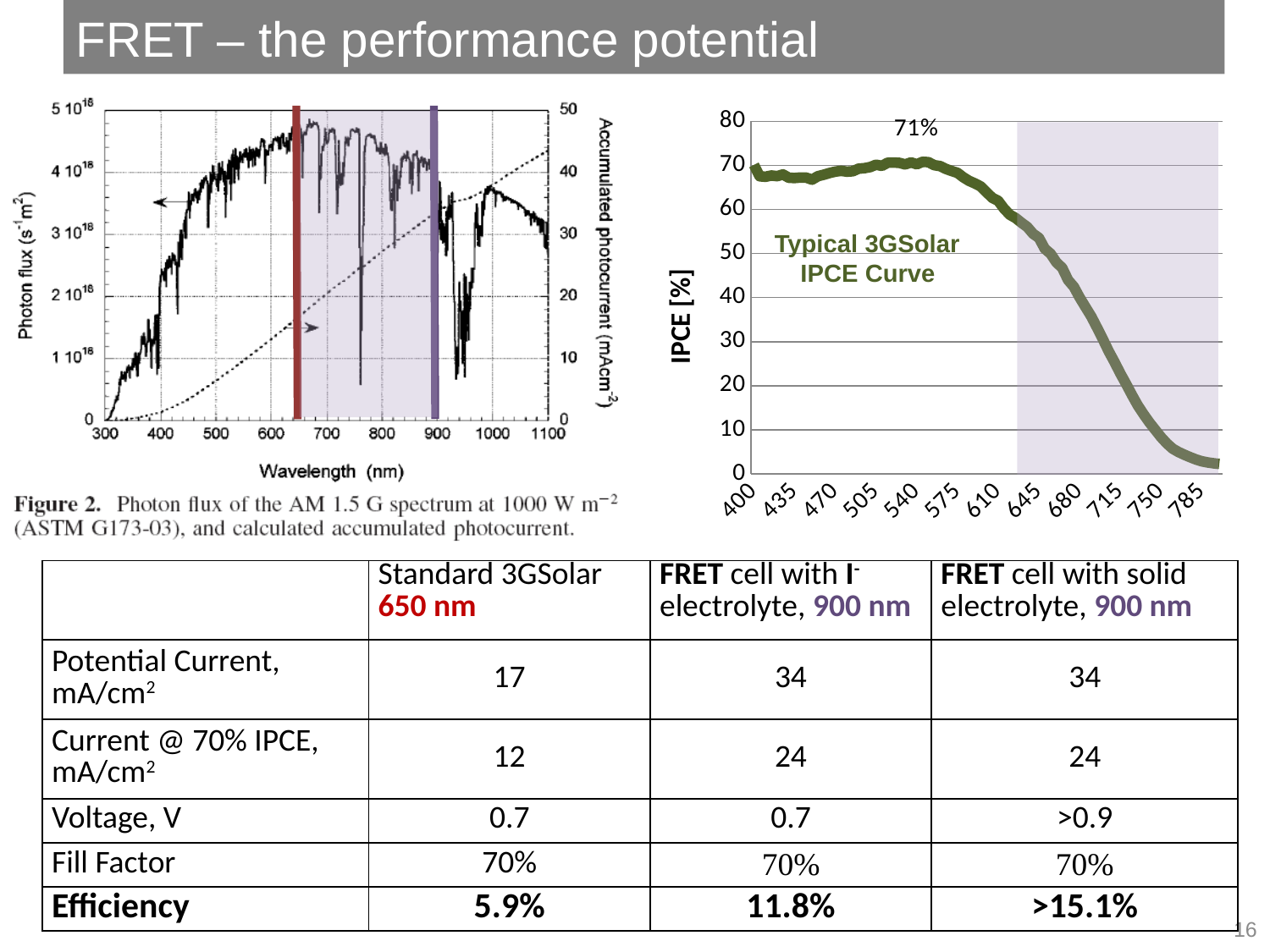
What is the y-axis label of the IPCE curve chart on the right? IPCE [%] On the IPCE curve chart on the right, which has the higher IPCE value: 540 nm or 750 nm? 540 nm On the IPCE curve chart on the right, is the IPCE value at 715 nm greater or less than 30? less On the IPCE curve chart on the right, is the IPCE value at 785 nm greater or less than 10? less On the IPCE curve chart on the right, what is the peak IPCE value labelled on the curve? 71% What is the x-axis label of the photon flux chart on the left? Wavelength (nm) How many tick labels are shown on the x axis of the IPCE curve chart on the right? 12 On the IPCE curve chart on the right, does the IPCE value rise or fall between 610 nm and 785 nm? fall On the IPCE curve chart on the right, is the IPCE value at 400 nm greater or less than 60? greater What kind of chart is the 'Typical 3GSolar IPCE Curve' chart on the right? line chart